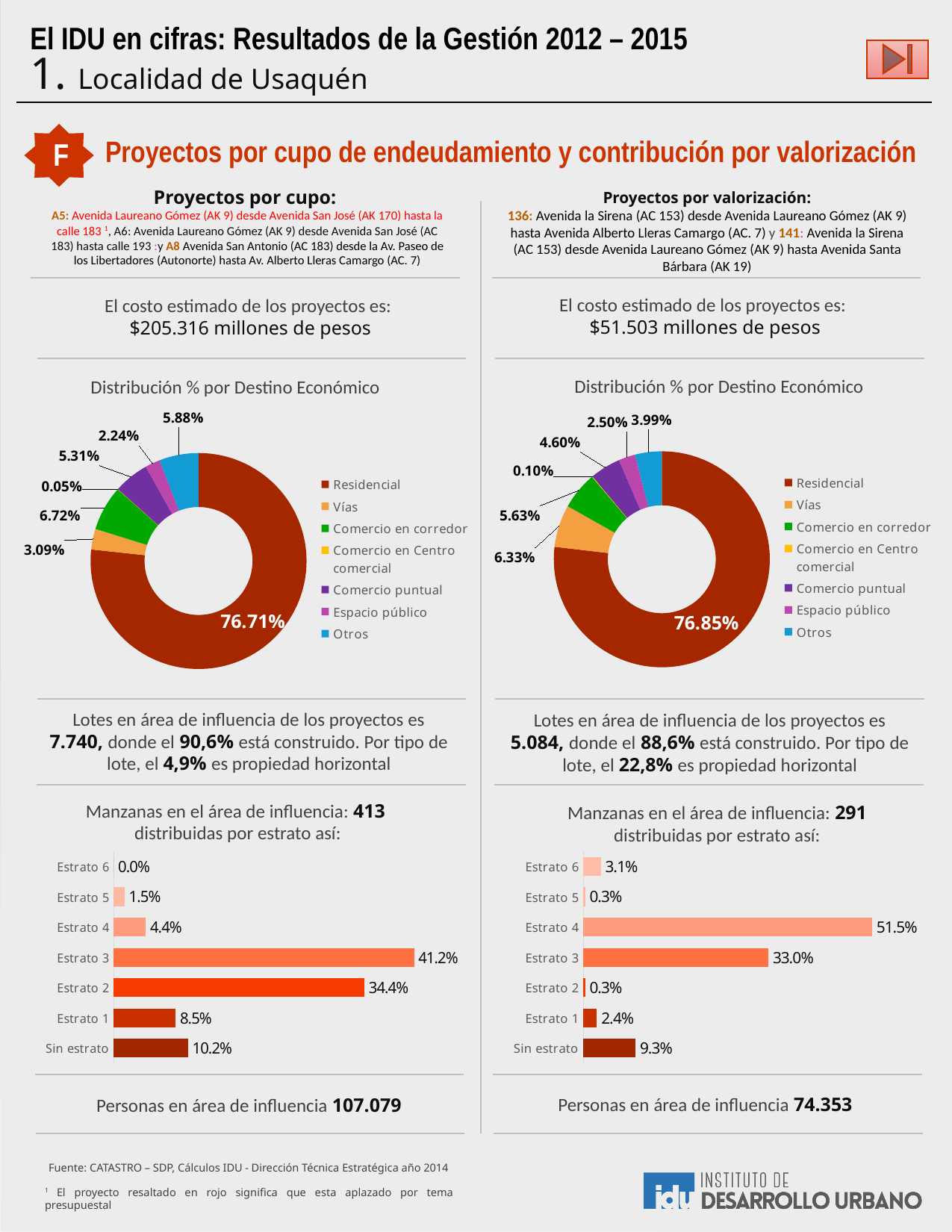
In the left donut chart (Proyectos por cupo), which category has the smallest share? Comercio en Centro comercial What type of chart is used for the Manzanas distribuidas por estrato on the left side of the slide? Bar chart In the right bar chart (Manzanas en el área de influencia, Proyectos por valorización), what is the value for Sin estrato? 9.3% In the left bar chart (Manzanas en el área de influencia, Proyectos por cupo), which estrato has the lowest value? Estrato 6 In the right donut chart (Proyectos por valorización, Distribución % por Destino Económico), what share does Vías have? 6.33% In the right bar chart (Manzanas en el área de influencia, Proyectos por valorización), which estrato has the highest value? Estrato 4 In the left bar chart (Manzanas en el área de influencia, Proyectos por cupo), what is the difference between Estrato 3 and Estrato 2? 6.8% In the left bar chart (Manzanas en el área de influencia, Proyectos por cupo), what is the value for Estrato 3? 41.2% In the right donut chart (Proyectos por valorización), what share does Otros have? 3.99% In the left donut chart (Proyectos por cupo, Distribución % por Destino Económico), what share does Residencial have? 76.71% In the right donut chart (Proyectos por valorización), which is larger, Comercio en corredor or Comercio puntual? Comercio en corredor How many entries does the legend of the left donut chart (Proyectos por cupo) list? 7